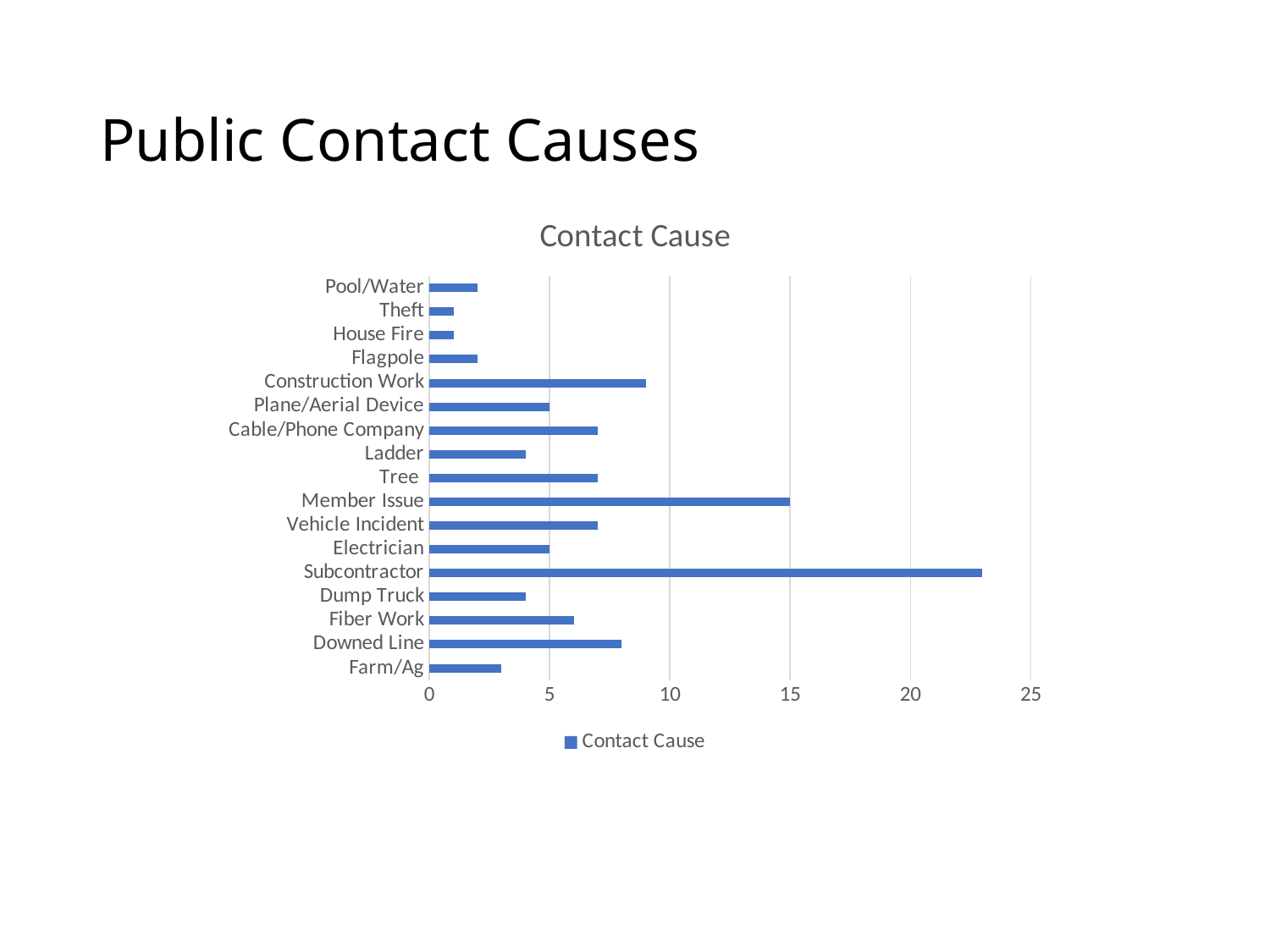
What is the value for Member Issue? 15 Is the value for Subcontractor greater or less than 20? greater Is the value for Farm/Ag greater or less than 5? less What type of chart is shown on the slide? Bar chart Which is larger, the value for Construction Work or the value for Ladder? Construction Work Which is larger, the value for Member Issue or the value for Subcontractor? Subcontractor What is the value for Electrician? 5 Which category has the highest value? Subcontractor What is the title of the chart? Contact Cause Is the value for Construction Work greater or less than 5? greater How many series does the legend list? 1 How many categories are plotted in the chart? 17